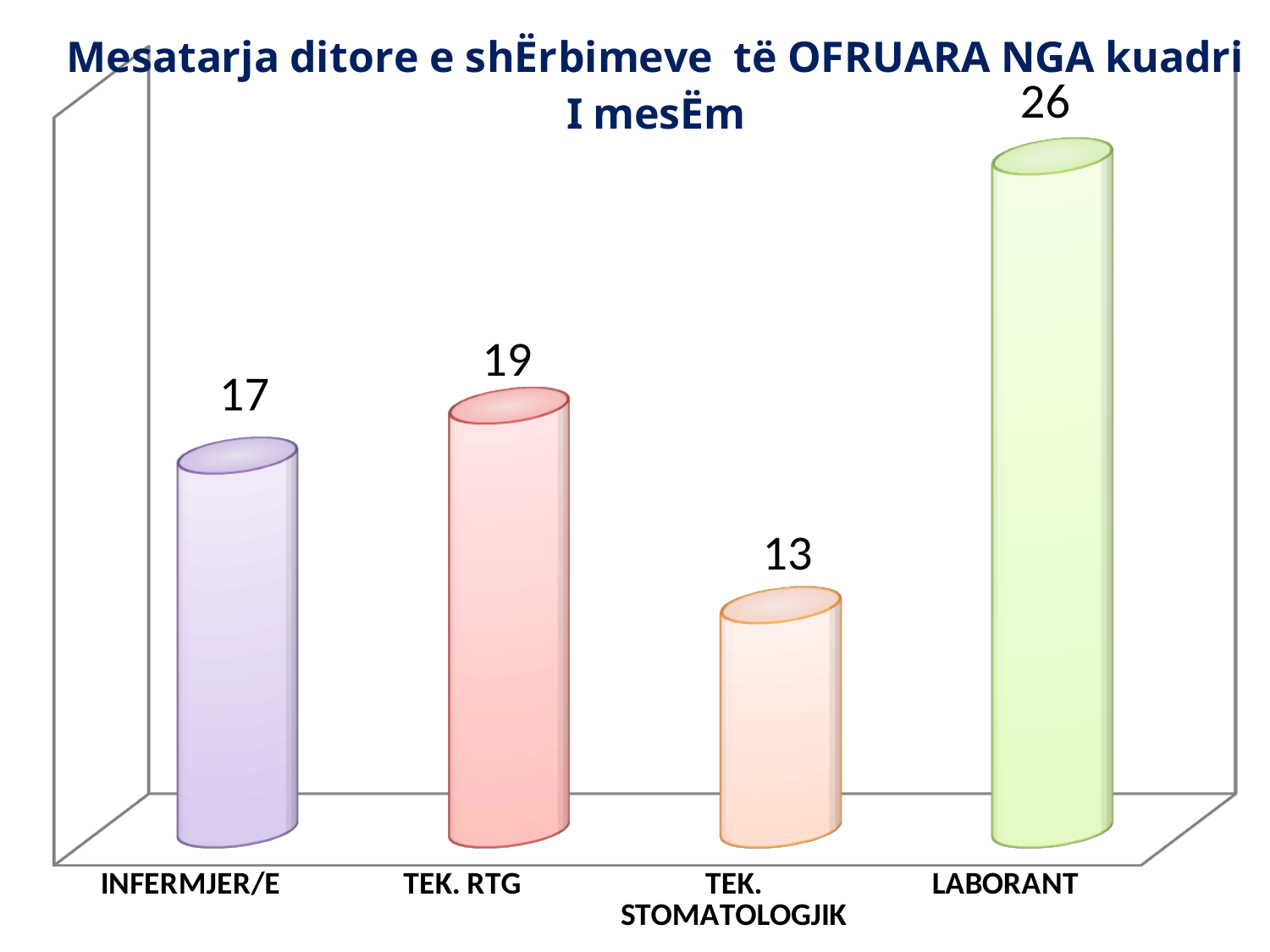
What kind of chart is shown on the slide? Bar chart What is the value for INFERMJER/E? 17 What is the value for TEK. RTG? 19 Which category has the lowest value? TEK. STOMATOLOGJIK Which category has the highest value? LABORANT What is the difference between the values for LABORANT and TEK. STOMATOLOGJIK? 13 What is the title of the chart? Mesatarja ditore e shËrbimeve të OFRUARA NGA kuadri I mesËm How many categories are shown in the chart? 4 What is the difference between the values for TEK. RTG and INFERMJER/E? 2 Which is larger, the value for TEK. RTG or the value for INFERMJER/E? TEK. RTG What is the value for TEK. STOMATOLOGJIK? 13 What is the value for LABORANT? 26